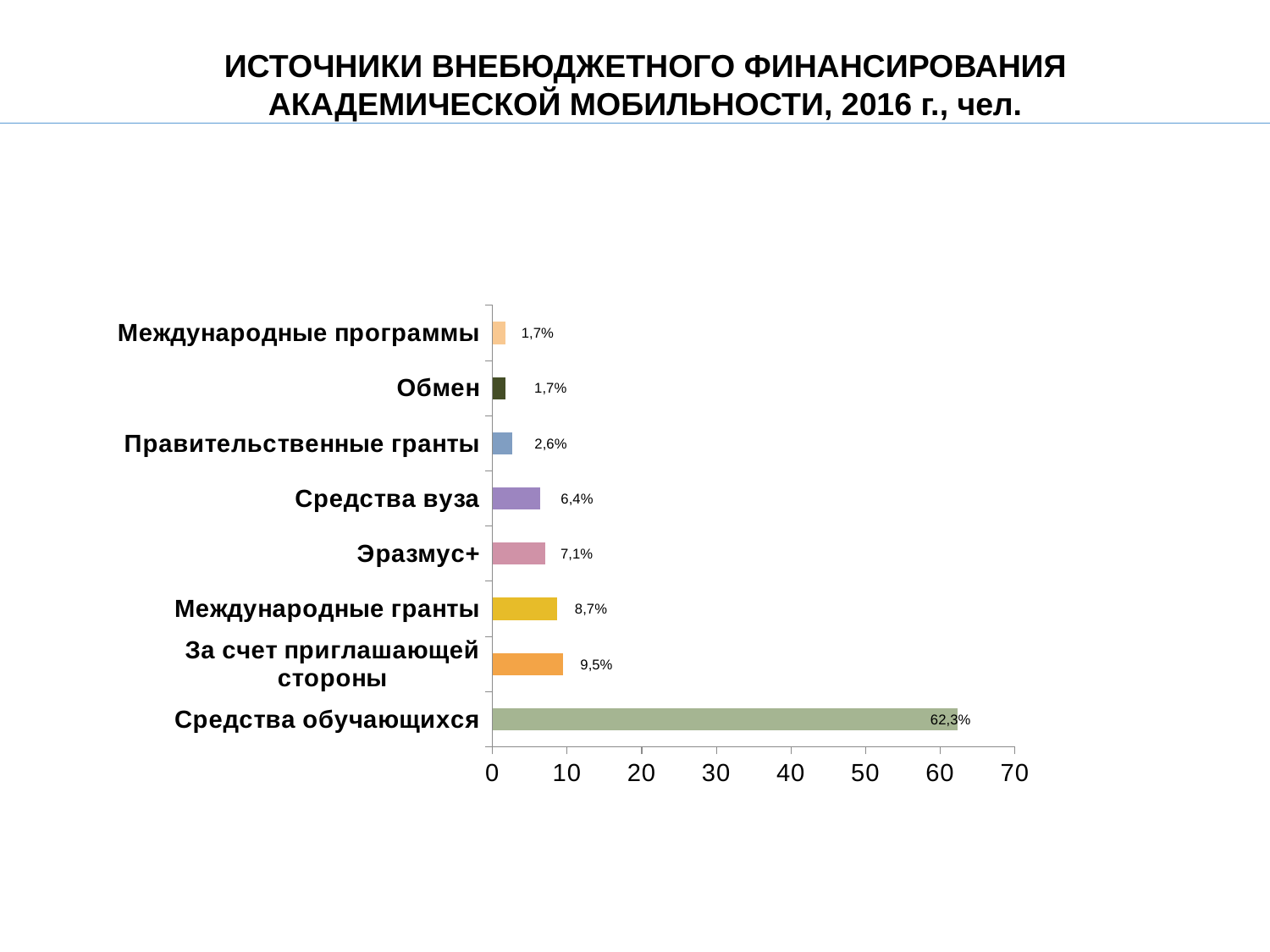
What is the value for Правительственные гранты? 2,6% What is the value for Средства обучающихся? 62,3% How many categories are shown in the chart? 8 What is the value for За счет приглашающей стороны? 9,5% Which is larger, the value for Эразмус+ or the value for Средства вуза? Эразмус+ Is the value for Средства обучающихся greater or less than 60? greater What is the value for Эразмус+? 7,1% What is the difference between the values for Средства обучающихся and За счет приглашающей стороны? 52,8% What is the title of the chart? ИСТОЧНИКИ ВНЕБЮДЖЕТНОГО ФИНАНСИРОВАНИЯ АКАДЕМИЧЕСКОЙ МОБИЛЬНОСТИ, 2016 г., чел. What is the difference between the values for Международные гранты and Средства вуза? 2,3% Which category has the highest value? Средства обучающихся What kind of chart is shown on the slide? bar chart